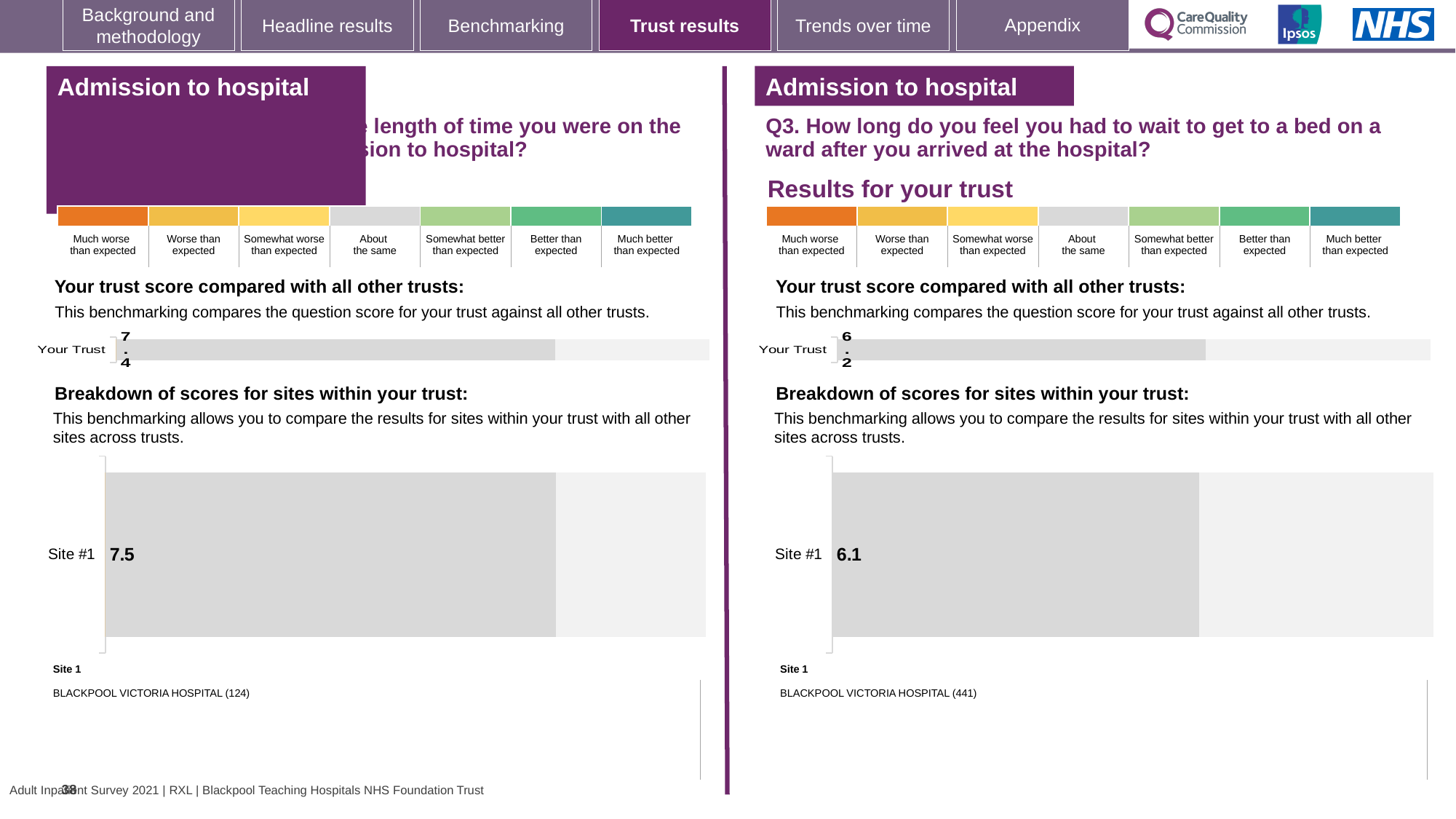
On the left half of the slide, what is the 'Your Trust' score shown in the trust benchmarking bar? 7.4 What type of chart is used to show the Site #1 score on the left half of the slide? bar chart On the right half of the slide (Q3), what score is shown for Site #1 in the breakdown of sites chart? 6.1 On the right half of the slide (Q3), what is the 'Your Trust' score shown in the trust benchmarking bar? 6.2 Which has the higher Site #1 score: the left chart or the right (Q3) chart? the left chart What is the number in brackets after BLACKPOOL VICTORIA HOSPITAL under Site 1 on the left half of the slide? 124 On the left half of the slide, what is the difference between the Site #1 score and the 'Your Trust' score? 0.1 What is the difference between the Site #1 score on the left chart and the Site #1 score on the right (Q3) chart? 1.4 Which hospital is listed as Site 1 on the right half of the slide (Q3)? BLACKPOOL VICTORIA HOSPITAL (441) How many sites are shown in the breakdown of sites chart on the right half of the slide (Q3)? 1 On the left half of the slide, what score is shown for Site #1 in the breakdown of sites chart? 7.5 On the right half of the slide (Q3), what is the difference between the 'Your Trust' score and the Site #1 score? 0.1